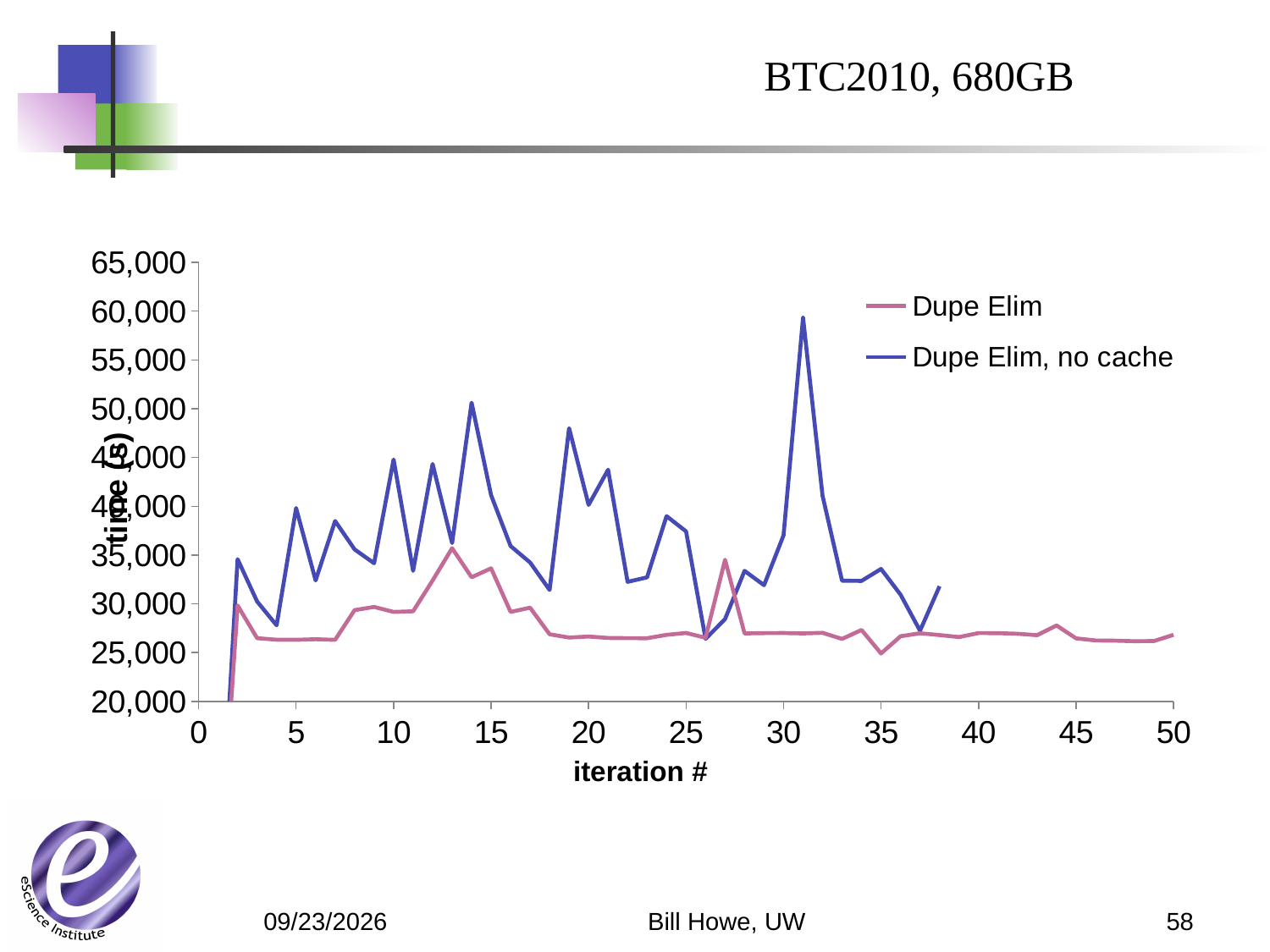
What is the label of the x axis? iteration # How many series does the legend list? 2 Is the value for Dupe Elim, no cache at iteration 14 greater or less than 45,000? greater At iteration 10, which series has the higher value, Dupe Elim or Dupe Elim, no cache? Dupe Elim, no cache Is the value for Dupe Elim at iteration 50 greater or less than 30,000? less Does the Dupe Elim series rise or fall between iteration 13 and iteration 18? fall What is the title of the chart? BTC2010, 680GB Is the value for Dupe Elim at iteration 13 greater or less than 30,000? greater Which series extends all the way to iteration 50? Dupe Elim What kind of chart is shown on the slide? line chart At which iteration does the Dupe Elim, no cache series reach its highest value? 31